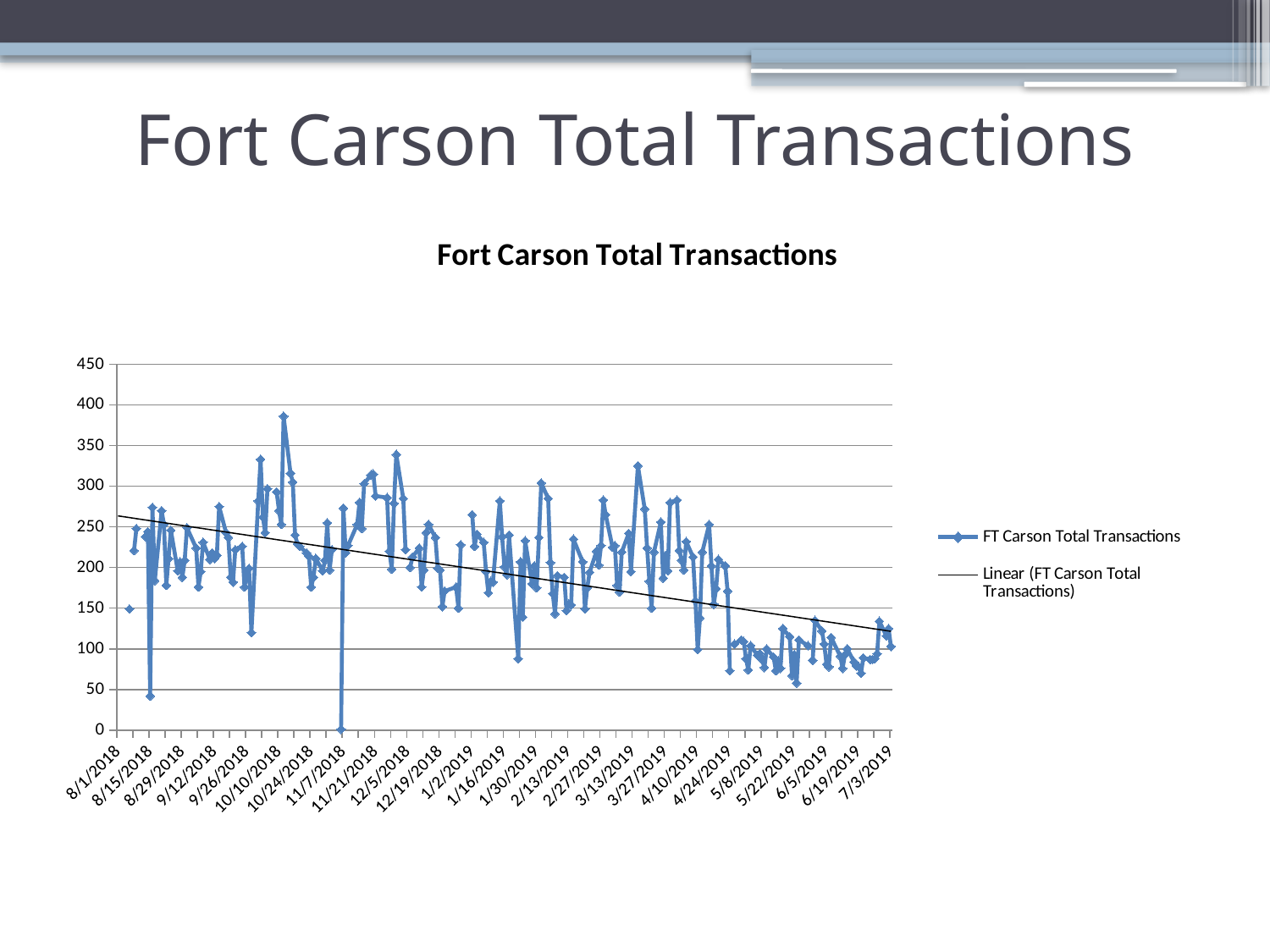
What is the maximum value shown on the vertical axis? 450 Is the value for 7/3/2019 greater or less than 150? less What is the name of the data series plotted with markers in the chart? FT Carson Total Transactions Which is larger, the value for 10/10/2018 or the value for 6/5/2019? 10/10/2018 What is the title of the chart? Fort Carson Total Transactions Do the values generally rise or fall from 8/1/2018 to 7/3/2019 according to the trendline? fall Is the highest value plotted in the chart greater or less than 350? greater Is the lowest value plotted in the chart greater or less than 50? less What kind of chart is shown on the slide? line chart How many entries does the chart legend list? 2